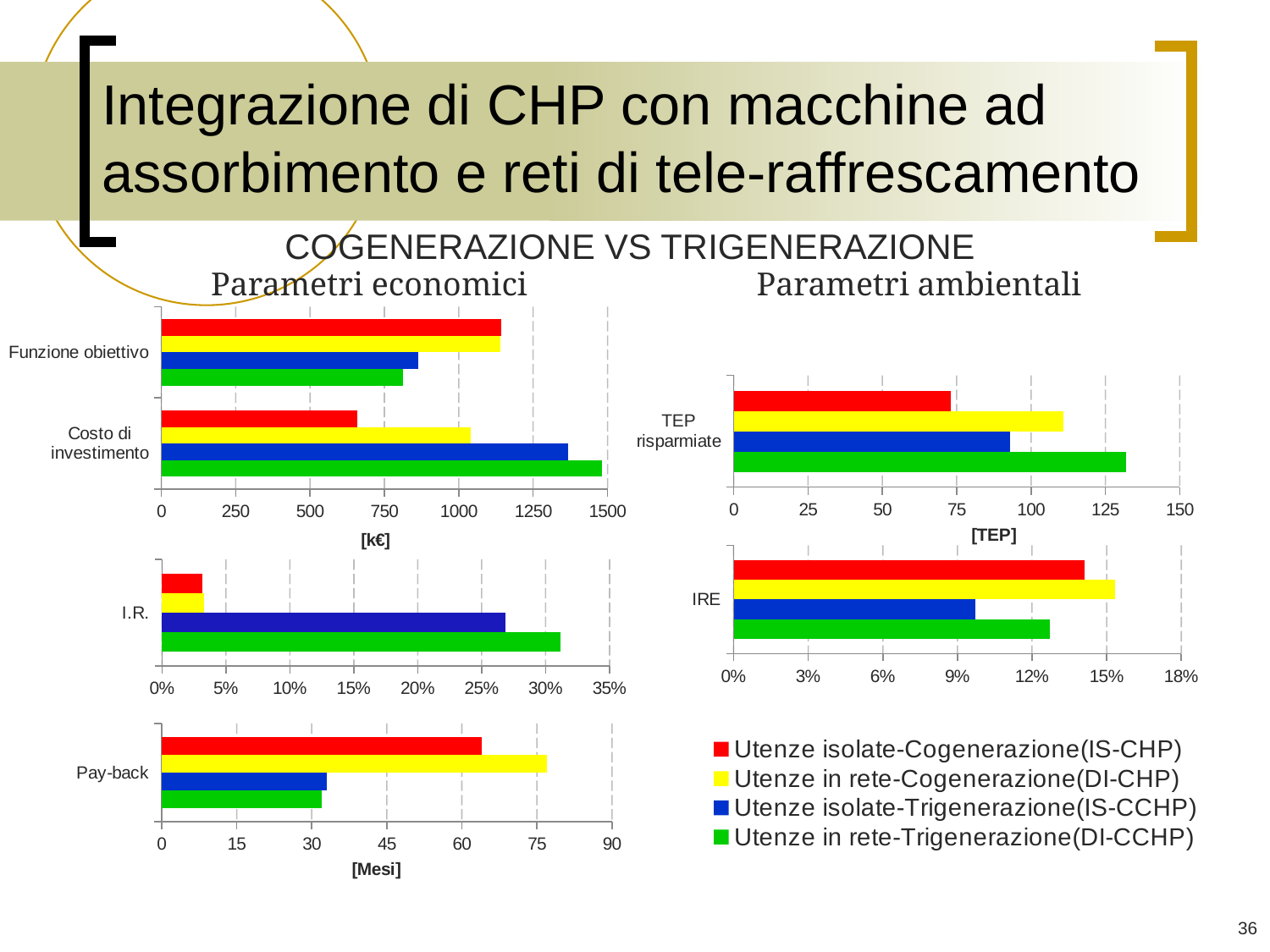
In the IRE chart, which series has the lowest value? Utenze isolate-Trigenerazione(IS-CCHP) In the TEP risparmiate chart, is the value for Utenze isolate-Cogenerazione(IS-CHP) greater or less than 100? less How many series does the legend list for the charts on this slide? 4 In the chart with the [k€] axis, for Funzione obiettivo, which is larger: Utenze isolate-Cogenerazione(IS-CHP) or Utenze isolate-Trigenerazione(IS-CCHP)? Utenze isolate-Cogenerazione(IS-CHP) In the Pay-back chart, is the value for Utenze isolate-Cogenerazione(IS-CHP) greater or less than 45? greater In the I.R. chart, is the value for Utenze in rete-Trigenerazione(DI-CCHP) greater or less than 25%? greater In the TEP risparmiate chart, which series has the highest value? Utenze in rete-Trigenerazione(DI-CCHP) In the Pay-back chart, which series has the highest value? Utenze in rete-Cogenerazione(DI-CHP) What kind of chart is the TEP risparmiate chart? bar chart What unit is shown on the x axis of the Pay-back chart? [Mesi] In the chart with the [k€] axis, which series has the highest value for Costo di investimento? Utenze in rete-Trigenerazione(DI-CCHP)